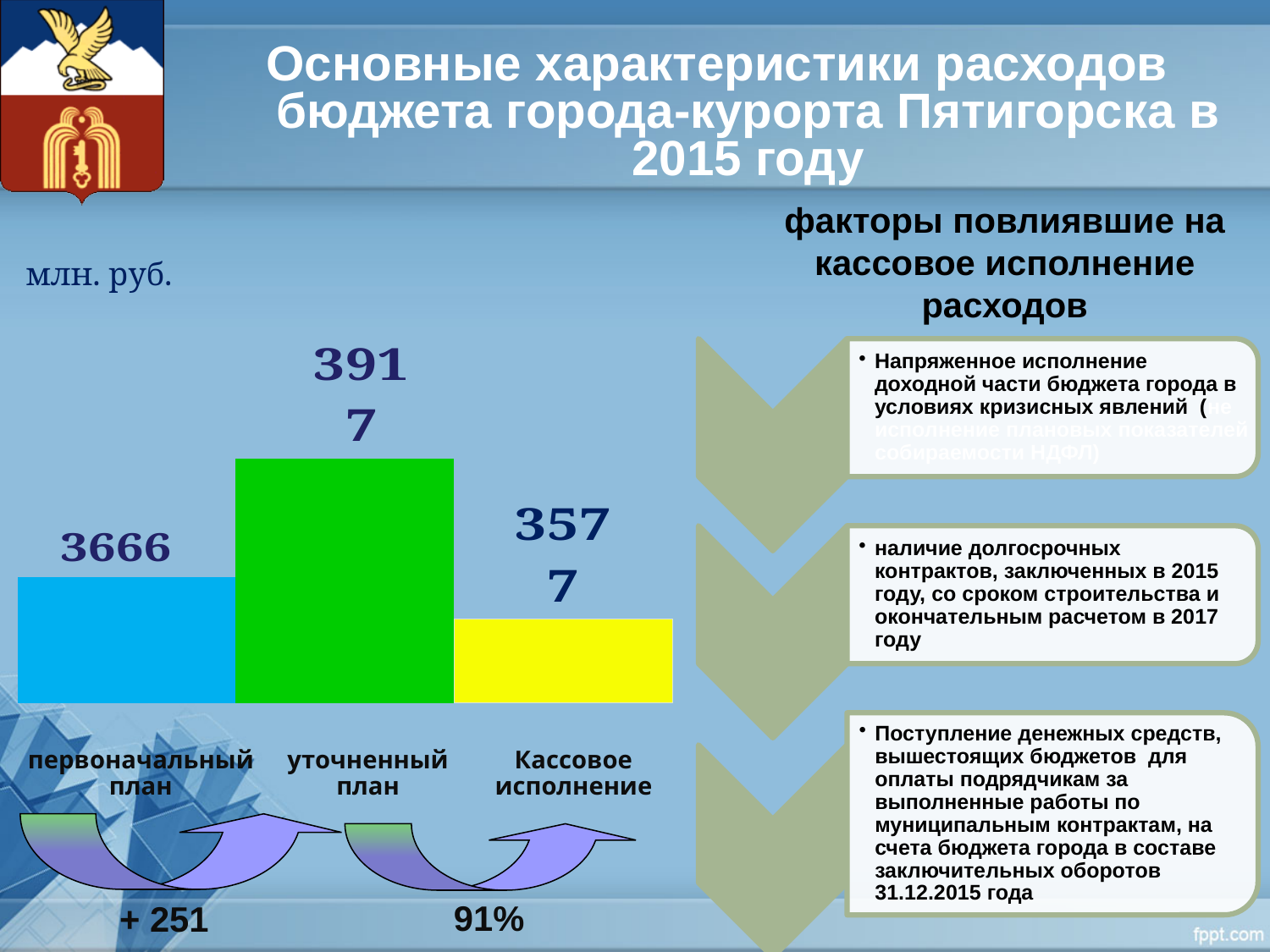
How many bars are in the chart? 3 Which category has the highest value? уточненный план What colour is the bar for уточненный план? green Which is larger, первоначальный план or Кассовое исполнение? первоначальный план What is the value for Кассовое исполнение? 3577 What kind of chart is shown? bar chart What is the difference between уточненный план and первоначальный план? 251 In what units are the chart values given? млн. руб. What is the value for уточненный план? 3917 What is the difference between уточненный план and Кассовое исполнение? 340 What is the value for первоначальный план? 3666 Which category has the lowest value? Кассовое исполнение